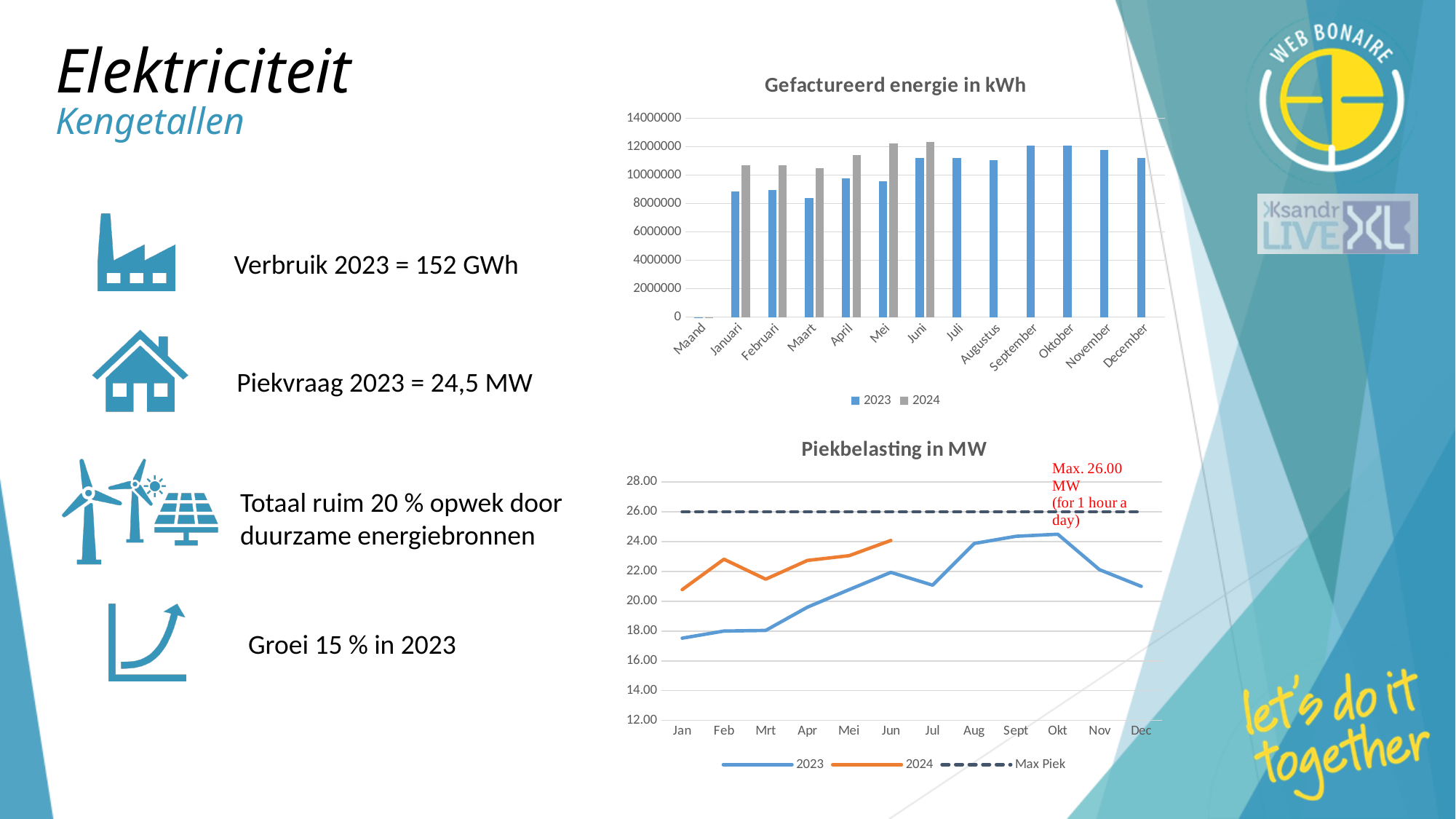
In the 'Piekbelasting in MW' chart, how many series does the legend list? 3 In the 'Piekbelasting in MW' chart, which month has the lowest 2023 value? Jan In the 'Gefactureerd energie in kWh' chart, is the 2024 value for Januari greater or less than 10000000? greater In the 'Gefactureerd energie in kWh' chart, which is larger for Januari: the 2023 value or the 2024 value? 2024 In the 'Gefactureerd energie in kWh' chart, is the 2023 value for Maart greater or less than 10000000? less What type of chart is the 'Gefactureerd energie in kWh' chart? bar chart In the 'Piekbelasting in MW' chart, does the 2024 series generally rise or fall from Jan to Jun? rise In the 'Gefactureerd energie in kWh' chart, for how many months is a 2024 bar shown? 6 In the 'Piekbelasting in MW' chart, what is the value of the Max Piek line? 26.00 In the 'Piekbelasting in MW' chart, which month has the highest 2024 value? Jun What type of chart is the 'Piekbelasting in MW' chart? line chart In the 'Gefactureerd energie in kWh' chart, how many series does the legend list? 2